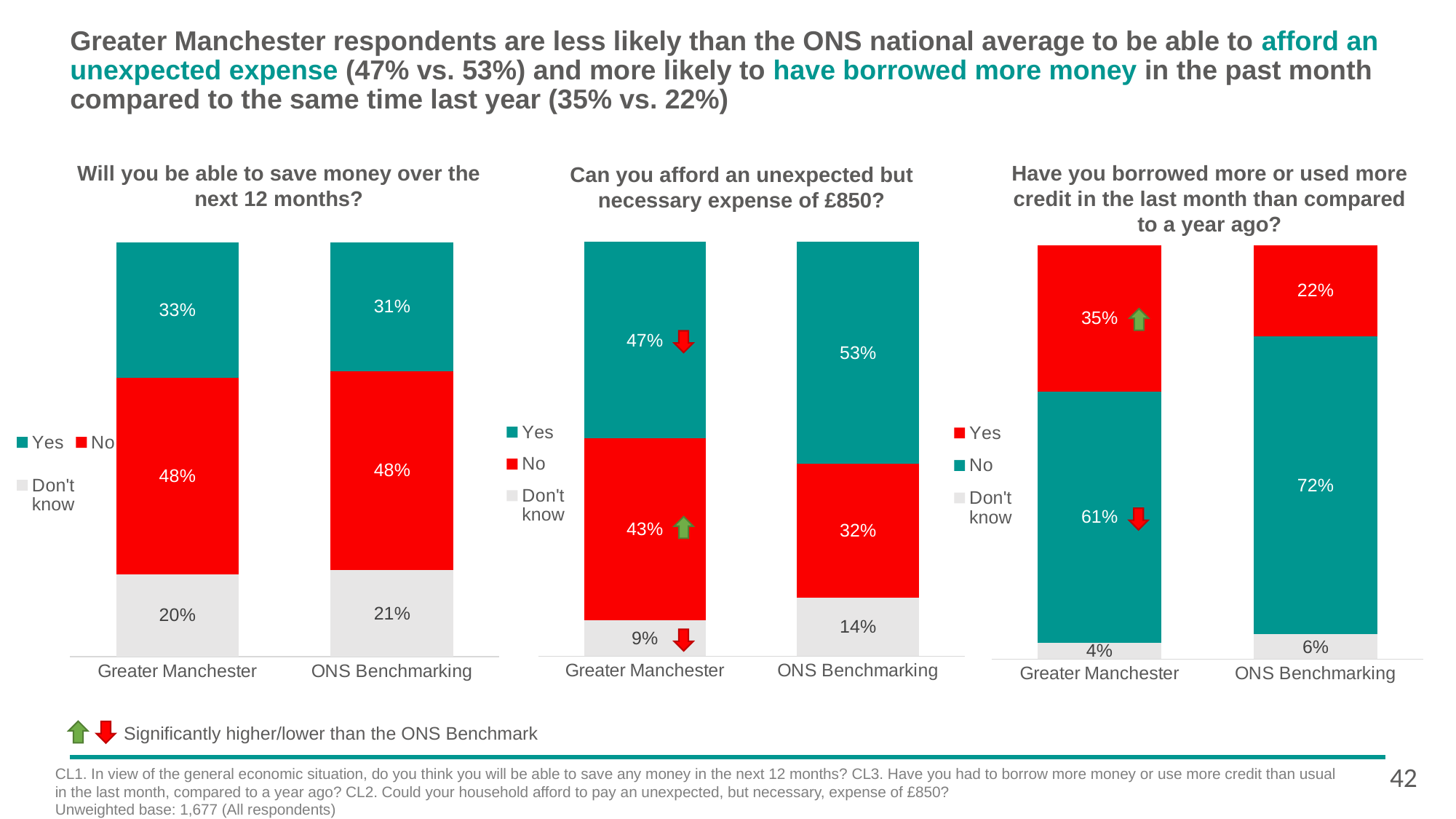
In the chart 'Can you afford an unexpected but necessary expense of £850?', what is the No value for Greater Manchester? 43% In the chart 'Will you be able to save money over the next 12 months?', what percentage of Greater Manchester respondents answered Yes? 33% In the chart 'Can you afford an unexpected but necessary expense of £850?', which response has the lowest value for ONS Benchmarking? Don't know How many bars are shown in the chart 'Have you borrowed more or used more credit in the last month than compared to a year ago?' 2 In the chart 'Will you be able to save money over the next 12 months?', what is the Don't know value for ONS Benchmarking? 21% In the chart 'Have you borrowed more or used more credit in the last month than compared to a year ago?', what is the difference between the Don't know values for ONS Benchmarking and Greater Manchester? 2 percentage points In the chart 'Will you be able to save money over the next 12 months?', which response has the highest value for Greater Manchester? No In the chart 'Have you borrowed more or used more credit in the last month than compared to a year ago?', which group has the higher Yes value, Greater Manchester or ONS Benchmarking? Greater Manchester In the chart 'Can you afford an unexpected but necessary expense of £850?', what is the difference between the Yes values for ONS Benchmarking and Greater Manchester? 6 percentage points How many series does the legend list in the chart 'Will you be able to save money over the next 12 months?' 3 In the chart 'Have you borrowed more or used more credit in the last month than compared to a year ago?', what is the No value for ONS Benchmarking? 72% What type of chart is used for 'Can you afford an unexpected but necessary expense of £850?' Stacked bar chart